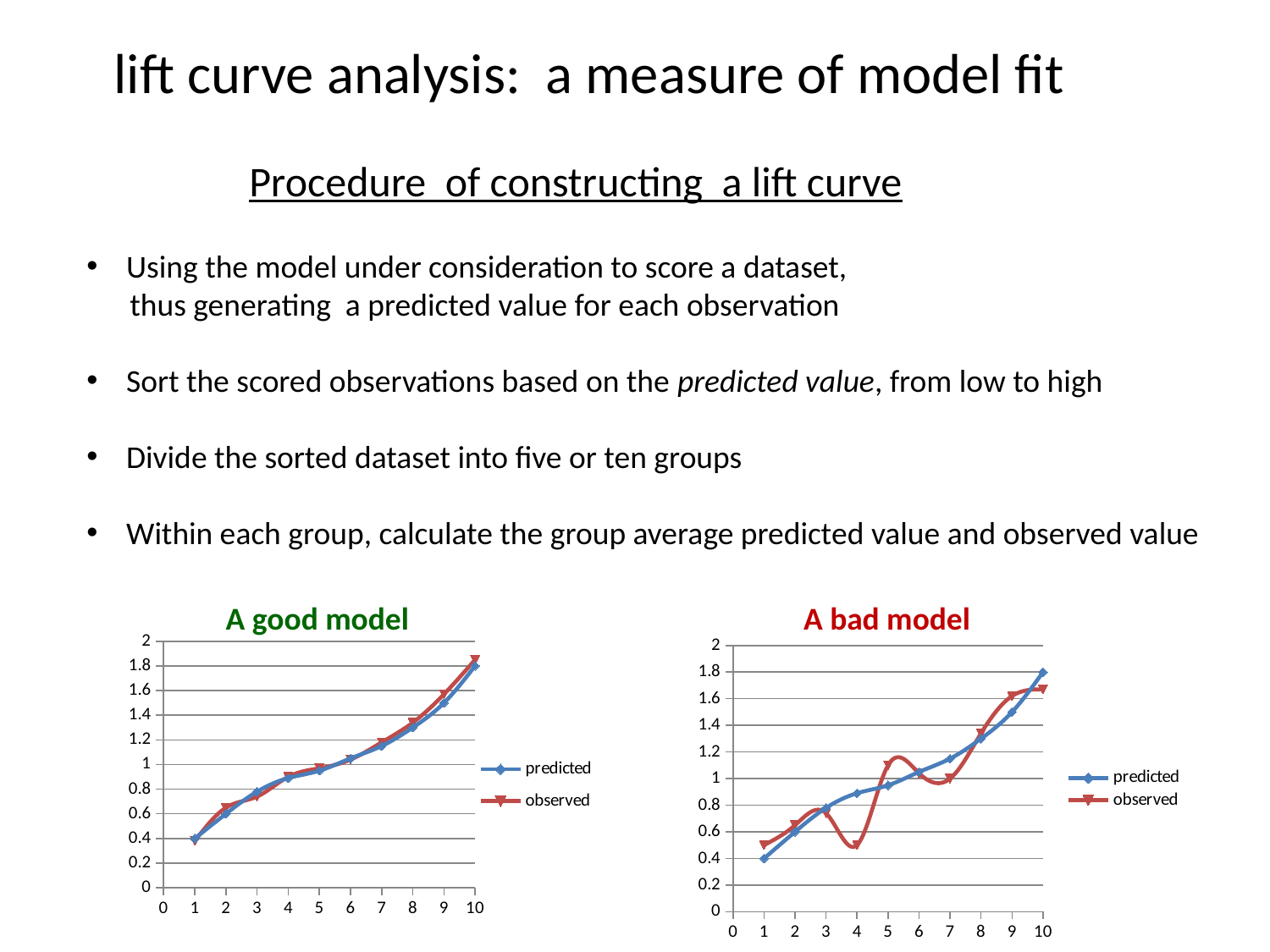
In the "A good model" chart, at which x value is the predicted series highest? 10 In the "A bad model" chart, at x = 7, which series has the larger value, predicted or observed? predicted How many data points does the predicted series have in the "A good model" chart? 10 In the "A good model" chart, is the predicted value at x = 9 greater or less than 1.4? greater In the "A bad model" chart, is the observed value at x = 5 greater or less than 1? greater In the "A bad model" chart, at x = 10, which series has the larger value, predicted or observed? predicted What are the two legend entries on the "A good model" chart? predicted, observed In the "A good model" chart, does the predicted series rise or fall as x increases from 1 to 10? rise What kind of chart is the "A good model" chart? line chart How many series does the legend of the "A bad model" chart list? 2 In the "A good model" chart, what is the predicted value at x = 1? 0.4 In the "A bad model" chart, is the observed value at x = 4 greater or less than 0.6? less